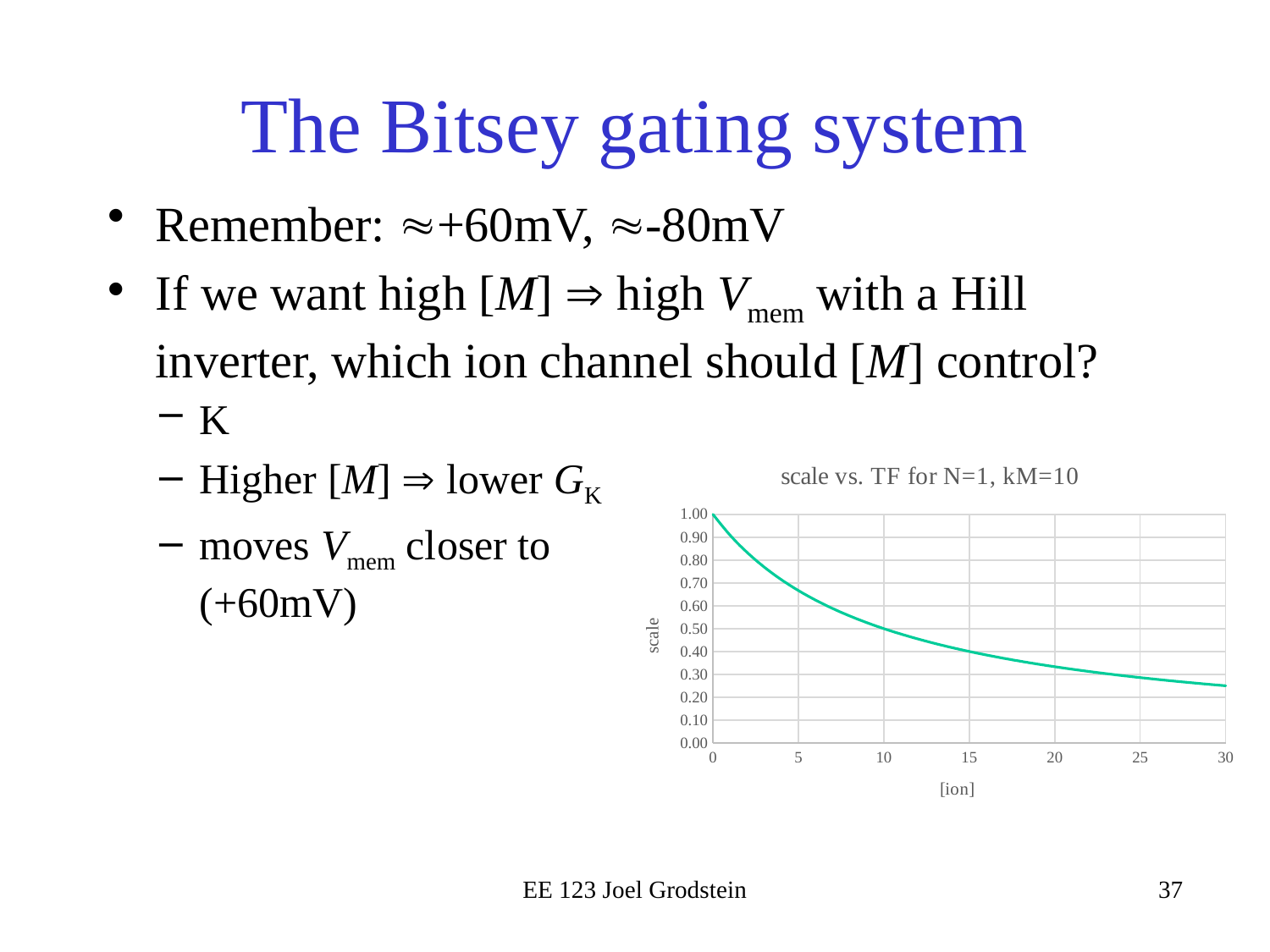
At which [ion] value on the x axis is the scale highest? 0 What is the title of the chart? scale vs. TF for N=1, kM=10 Which is larger, the scale value at [ion] = 5 or at [ion] = 20? [ion] = 5 What is the scale value when [ion] is 0? 1.00 Is the scale value at [ion] = 20 greater or less than 0.40? less Is the scale value at [ion] = 5 greater or less than 0.60? greater What is the scale value when [ion] is 10? 0.50 What kind of chart is shown on the slide? line chart Does the scale value rise or fall as [ion] increases along the x axis? fall What is the label of the x axis of the chart? [ion] Is the scale value at [ion] = 30 greater or less than 0.30? less At which [ion] value on the x axis is the scale lowest? 30